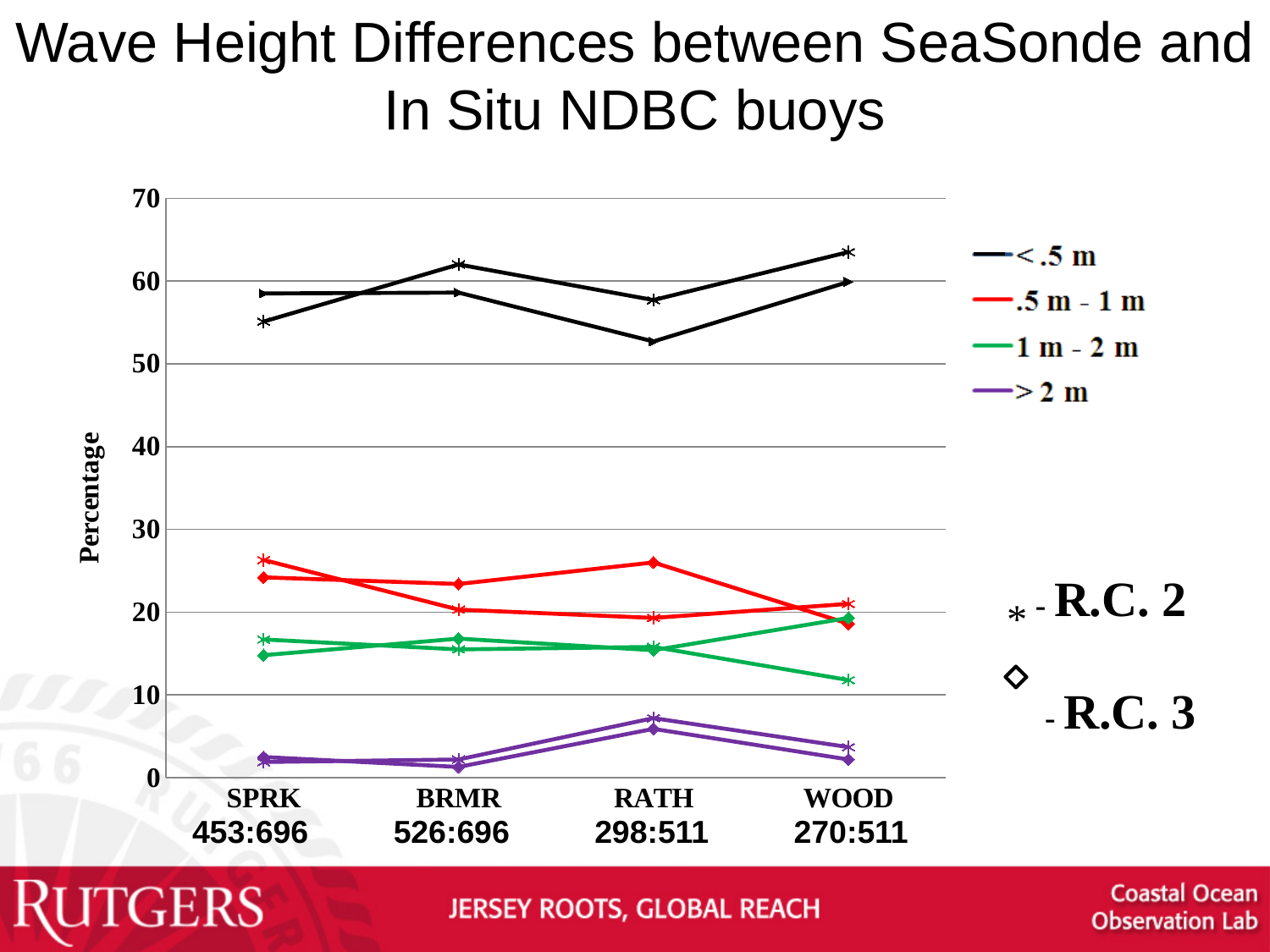
At SPRK, which series has the larger value: '.5 m - 1 m' or '1 m - 2 m'? .5 m - 1 m Is the value for the '.5 m - 1 m' series at SPRK greater or less than 20? greater How many series does the chart's legend list? 4 Is the value for the '> 2 m' series at RATH greater or less than 10? less What kind of chart is shown on the slide? line chart How many categories are shown on the x axis of the chart? 4 Do the values for the '> 2 m' series rise or fall from BRMR to RATH? rise Is the value for the '< .5 m' series at WOOD greater or less than 50? greater What is the label on the y axis of the chart? Percentage Which category has the highest values for the '< .5 m' series? WOOD At SPRK, which series has the larger value: '< .5 m' or '> 2 m'? < .5 m